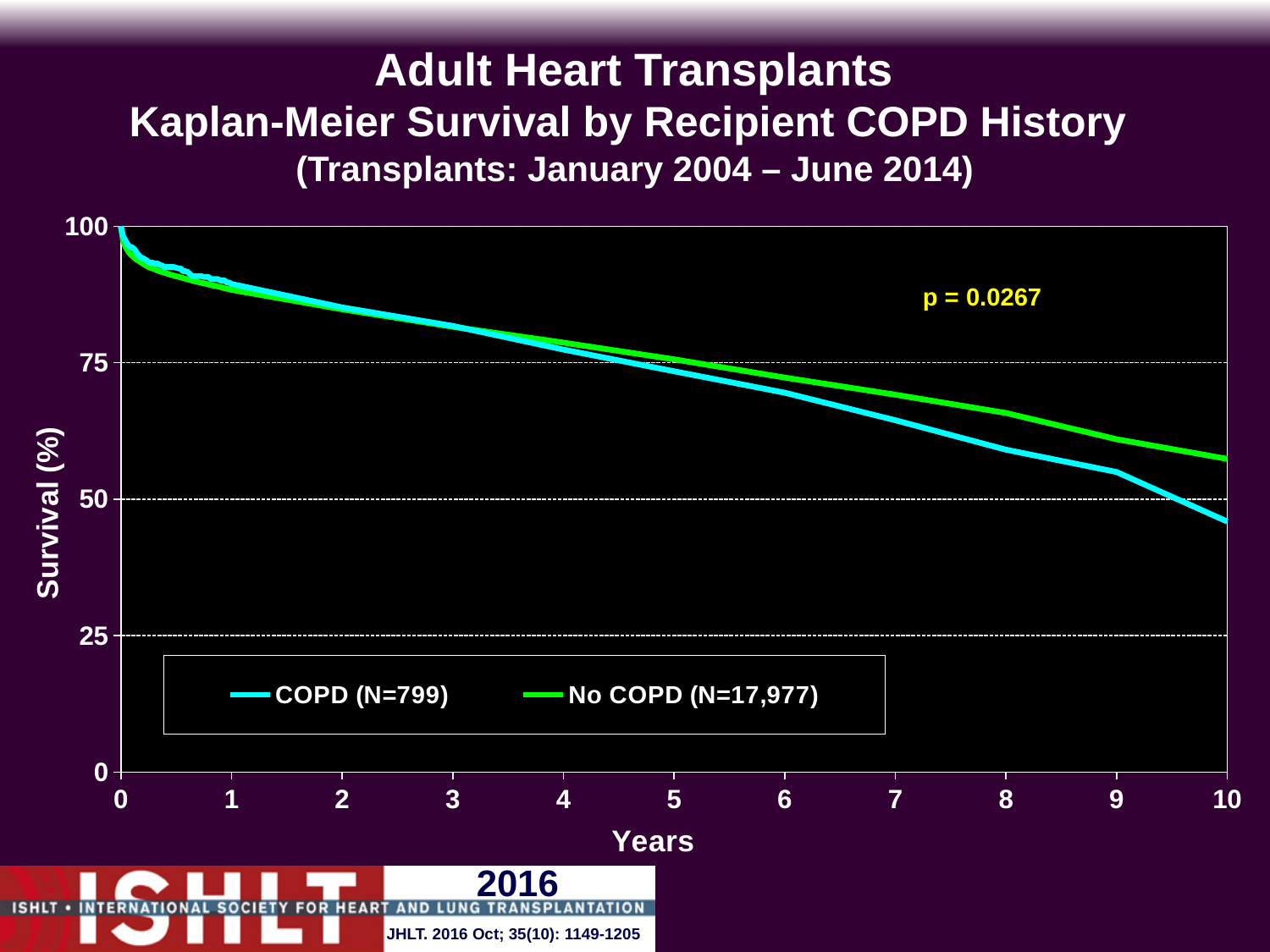
What kind of chart is shown on the slide? Line chart Do the survival curves rise or fall as years increase? Fall What is the N for the COPD group shown in the legend? 799 Is the survival value for COPD at 9 years greater or less than 50? greater Is the survival value for COPD at 10 years greater or less than 50? less What p-value is printed on the chart? p = 0.0267 Which group has the lowest survival at the end of the 10-year follow-up? COPD At 10 years, which group has higher survival, COPD or No COPD? No COPD Is the survival value for No COPD at 10 years greater or less than 50? greater How many series does the legend list? 2